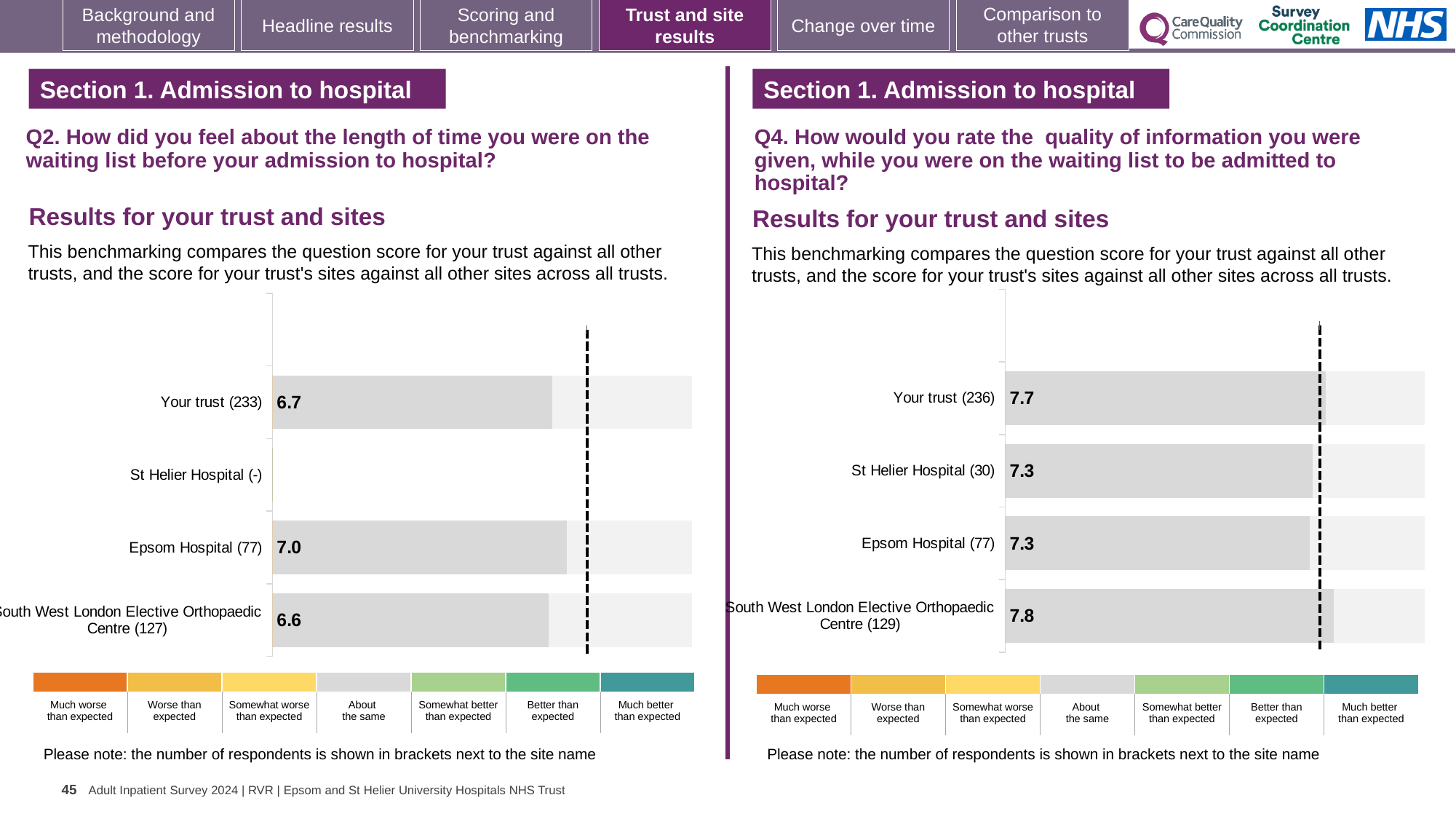
In the Q2 chart on the left, what is the difference between the scores for Epsom Hospital (77) and Your trust (233)? 0.3 In the Q4 chart on the right, what is the difference between the scores for South West London Elective Orthopaedic Centre (129) and St Helier Hospital (30)? 0.5 In the Q2 chart on the left, what is the score for Epsom Hospital (77)? 7.0 In the Q4 chart on the right, what is the score for St Helier Hospital (30)? 7.3 In the Q2 chart on the left, which site has the highest score? Epsom Hospital (77) What kind of chart is the Q4 chart on the right? Bar chart In the Q4 chart on the right, what is the score for Your trust (236)? 7.7 In the Q4 chart on the right, which category has the highest score? South West London Elective Orthopaedic Centre (129) In the Q2 chart on the left, what is the score for Your trust (233)? 6.7 In the Q2 chart on the left, which category has the lowest plotted score? South West London Elective Orthopaedic Centre (127) In the Q4 chart on the right, which is larger: the score for Your trust (236) or the score for Epsom Hospital (77)? Your trust (236) In the Q2 chart on the left, what is the score for South West London Elective Orthopaedic Centre (127)? 6.6